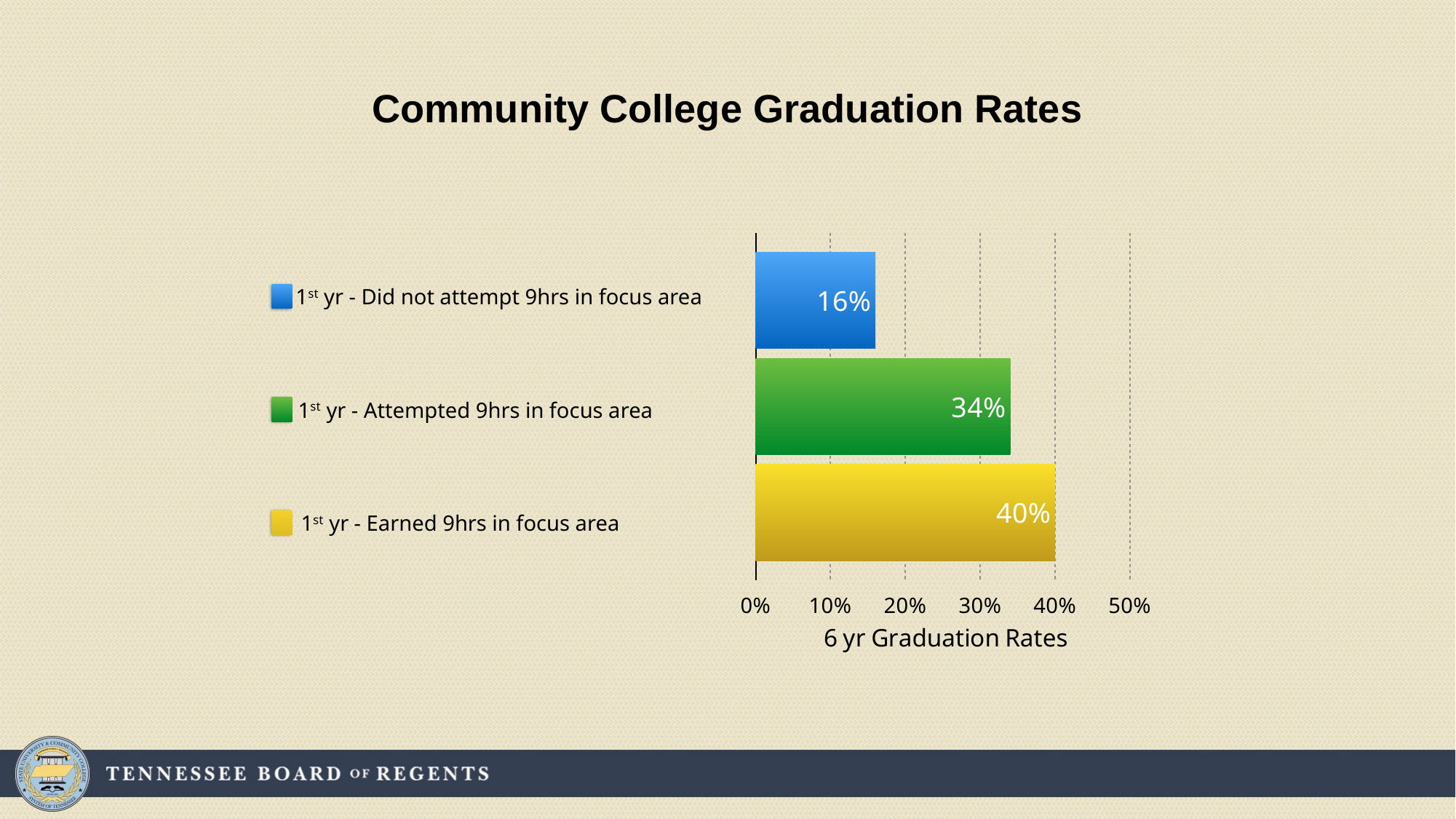
What is the difference in graduation rate between students who earned 9hrs and those who attempted 9hrs in the focus area? 6% How many groups are shown in the chart? 3 What is the title of the chart? Community College Graduation Rates Which group has a higher graduation rate: those who attempted 9hrs or those who did not attempt 9hrs in the focus area? 1st yr - Attempted 9hrs in focus area What type of chart is shown on the slide? Bar chart Which group has the lowest 6 yr graduation rate? 1st yr - Did not attempt 9hrs in focus area Which group has the highest 6 yr graduation rate? 1st yr - Earned 9hrs in focus area What is the 6 yr graduation rate for students who attempted 9hrs in the focus area in their 1st yr? 34% Is the graduation rate for students who attempted 9hrs in the focus area greater or less than 30%? greater What is the 6 yr graduation rate for students who did not attempt 9hrs in the focus area in their 1st yr? 16% What is the difference in graduation rate between students who earned 9hrs and those who did not attempt 9hrs in the focus area? 24% What is the 6 yr graduation rate for students who earned 9hrs in the focus area in their 1st yr? 40%